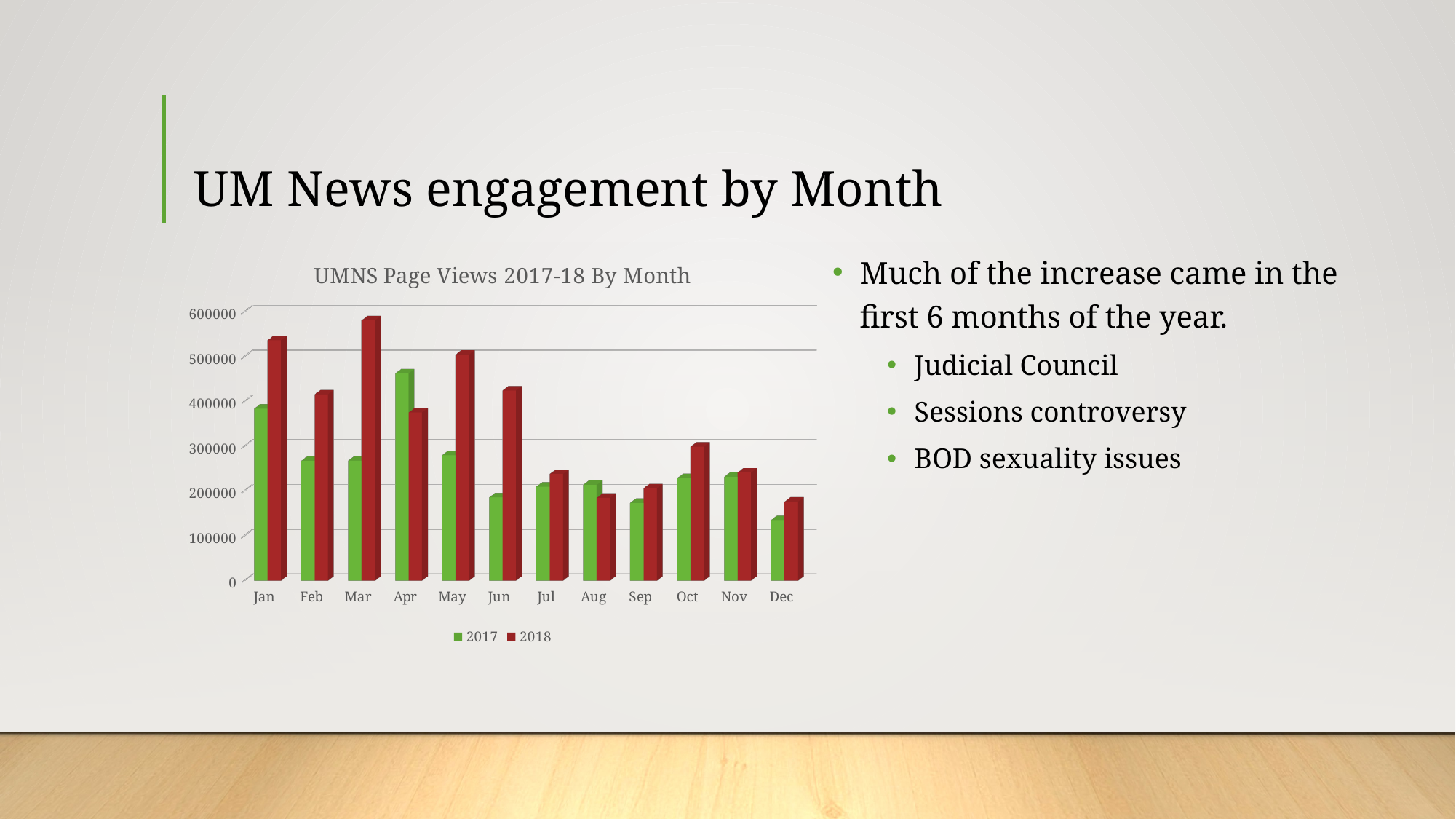
Which month has the lowest value for the 2018 series? Dec Which month has the highest value for the 2018 series? Mar In April, which series has the larger value, 2017 or 2018? 2017 Which month has the lowest value for the 2017 series? Dec Is the value for 2017 in December greater or less than 200000? less In January, which series has the larger value, 2017 or 2018? 2018 Which month has the highest value for the 2017 series? Apr How many series does the chart's legend list? 2 What kind of chart is shown on the slide? bar chart What is the title of the chart? UMNS Page Views 2017-18 By Month Is the value for 2018 in March greater or less than 500000? greater How many months are shown on the x axis of the chart? 12